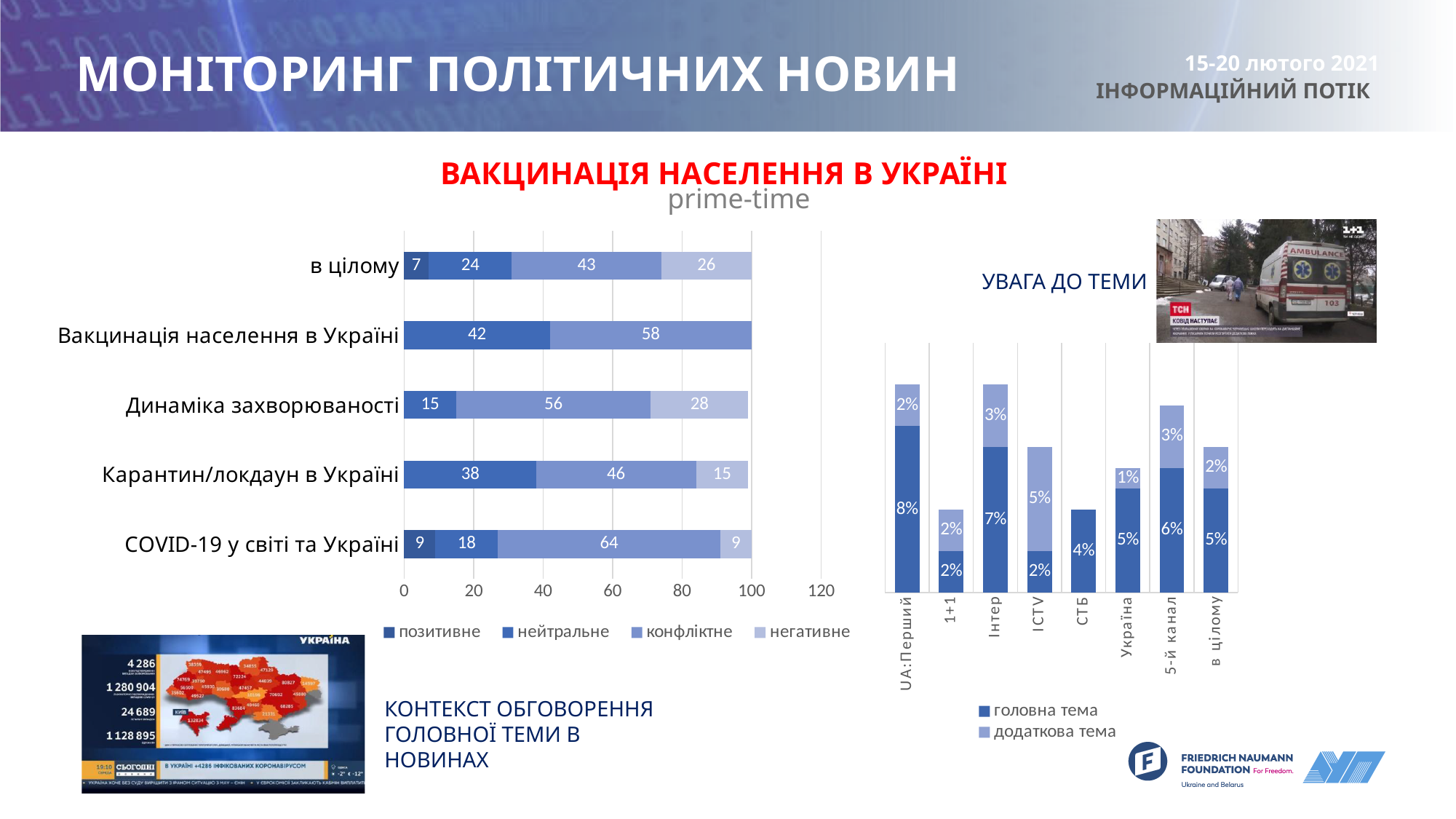
What kind of chart is the УВАГА ДО ТЕМИ chart? Stacked bar chart On the УВАГА ДО ТЕМИ chart, what is the додаткова тема value for ICTV? 5% On the prime-time chart, what is the difference between the конфліктне and нейтральне values for Карантин/локдаун в Україні? 8 On the УВАГА ДО ТЕМИ chart, what is the total of the stacked bar for 5-й канал? 9% On the prime-time chart, what is the негативне value for Динаміка захворюваності? 28 On the prime-time chart, which category has the highest конфліктне value? COVID-19 у світі та Україні On the prime-time chart, what is the нейтральне value for Вакцинація населення в Україні? 42 On the prime-time chart, how many categories are shown? 5 On the УВАГА ДО ТЕМИ chart, which channel has the highest головна тема value? UA:Перший On the УВАГА ДО ТЕМИ chart, what is the головна тема value for Інтер? 7% On the prime-time chart, what is the конфліктне value for COVID-19 у світі та Україні? 64 On the prime-time chart, how many series does the legend list? 4